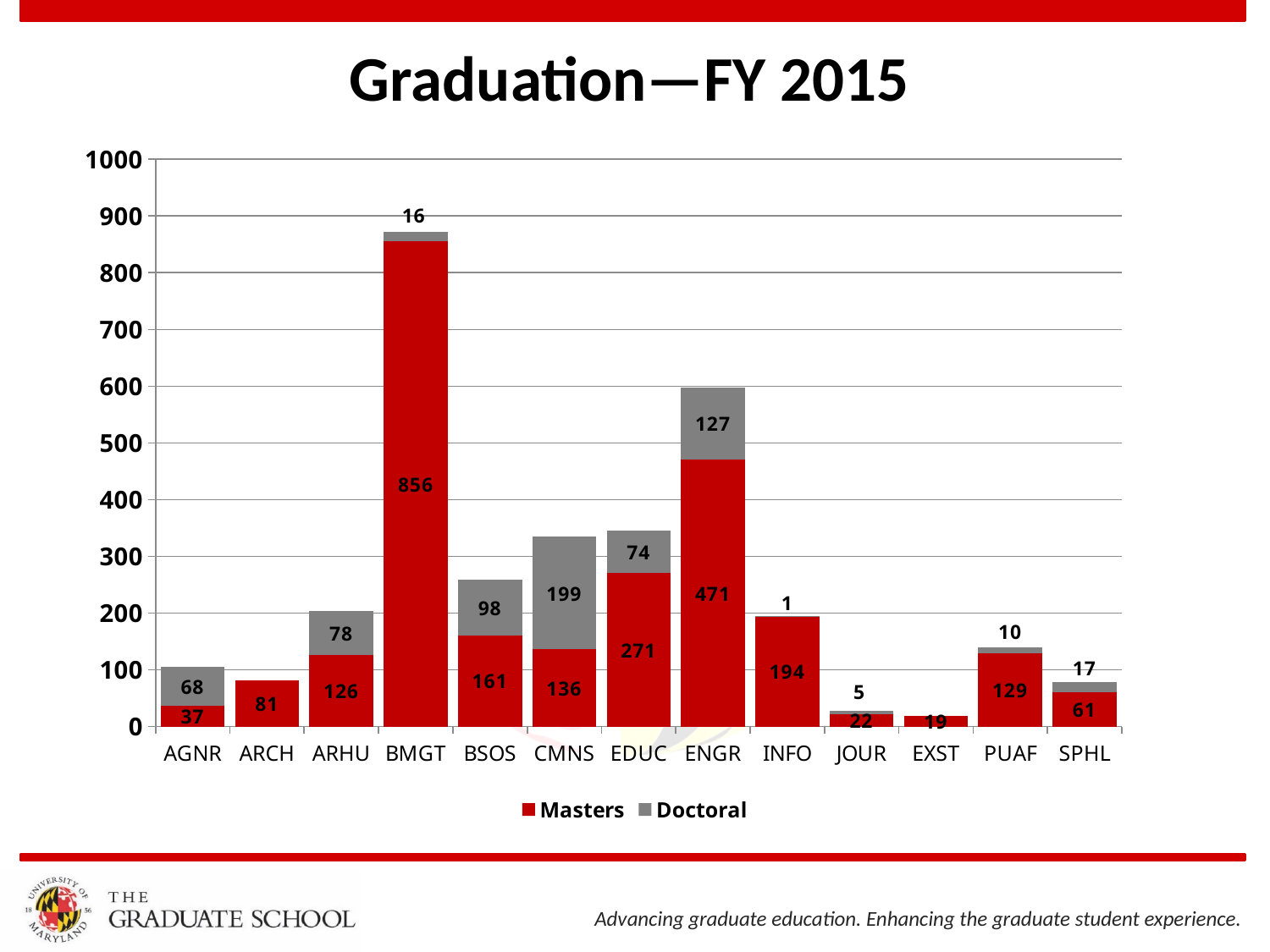
How many categories are shown on the x axis? 13 Which category has the lowest Masters value? EXST What is the Doctoral value for CMNS? 199 What is the difference between the Masters values for EDUC and BSOS? 110 How many series does the legend list? 2 What kind of chart is shown on the slide? Stacked bar chart Which is larger, the Doctoral value for ARHU or the Doctoral value for EDUC? ARHU What is the total of the stacked bar for ENGR? 598 What is the Masters value for BMGT? 856 Which category has the highest Masters value? BMGT What is the Masters value for ENGR? 471 Which category has the highest Doctoral value? CMNS